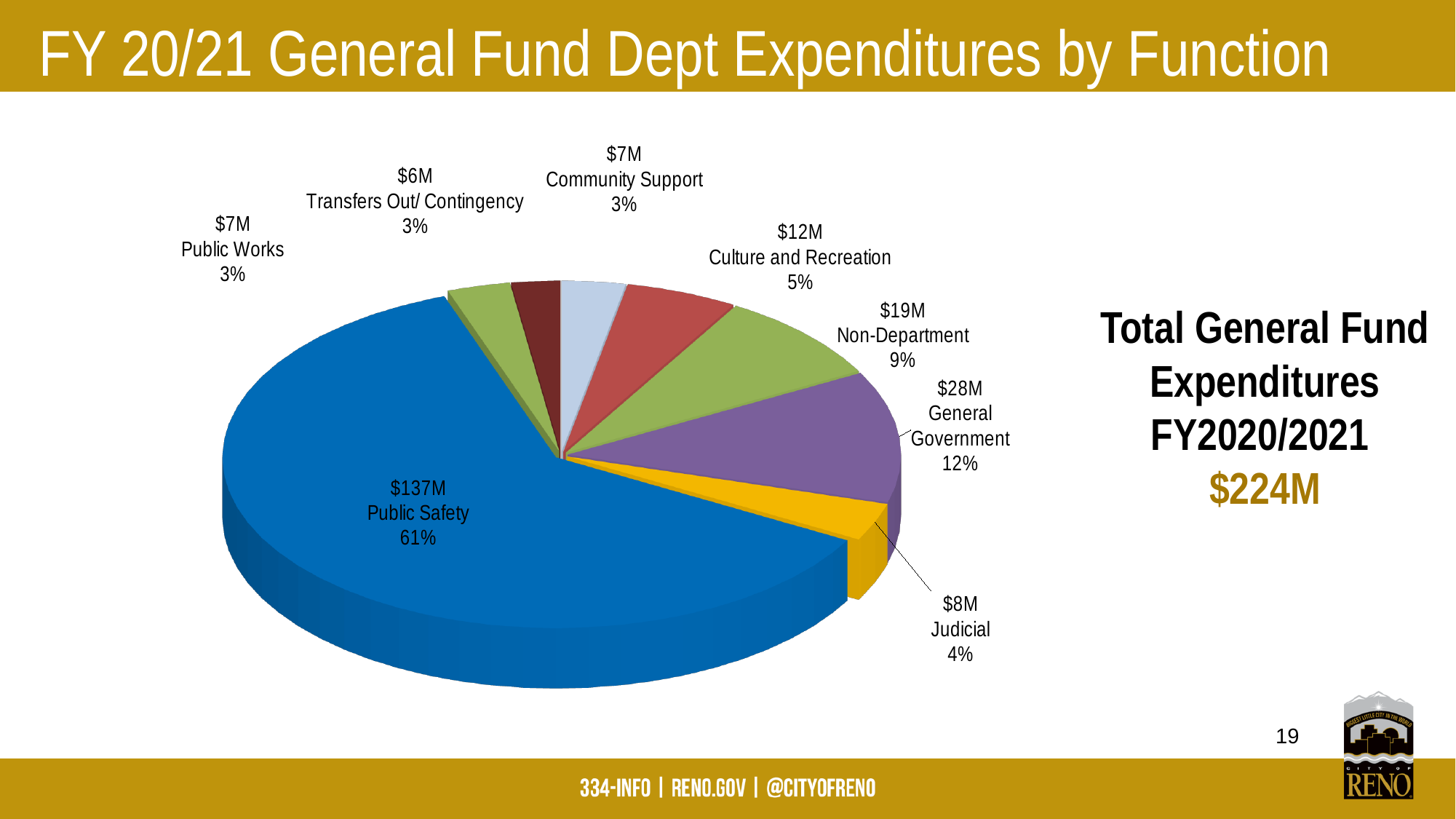
What is the difference in expenditure between General Government and Non-Department? $9M What is the expenditure amount for Non-Department? $19M How many slices does the pie chart have? 8 What share of the pie does Judicial represent? 4% What is the expenditure amount for Public Safety? $137M Which function has the smallest expenditure amount? Transfers Out/ Contingency What share of the pie does General Government represent? 12% What kind of chart is shown on the slide? Pie chart What total General Fund expenditure figure is shown on the slide? $224M Which is larger, the expenditure for Culture and Recreation or for Judicial? Culture and Recreation What is the expenditure amount for Community Support? $7M Which function has the largest expenditure? Public Safety